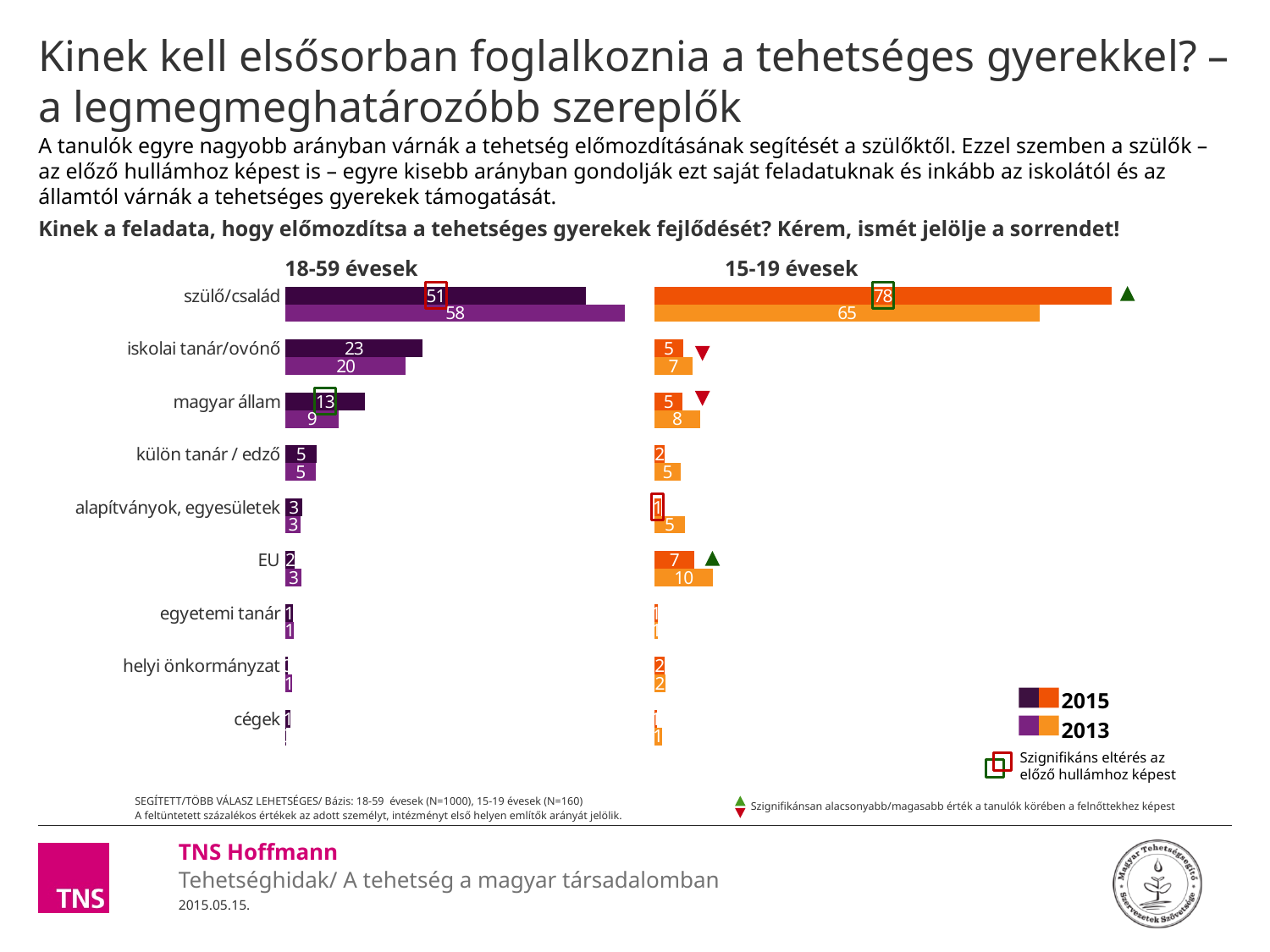
In the "15-19 évesek" chart, what is the difference between the 2015 and 2013 values for szülő/család? 13 In the "15-19 évesek" chart, what is the 2013 value for EU? 10 In the "18-59 évesek" chart, which is larger for magyar állam: the 2015 value or the 2013 value? 2015 In the "18-59 évesek" chart, what is the difference between the 2013 and 2015 values for szülő/család? 7 How many categories are listed in the "18-59 évesek" chart? 9 In the "18-59 évesek" chart, what is the 2013 value for iskolai tanár/ovónő? 20 How many series does the legend list? 2 In the "15-19 évesek" chart, which is larger for EU: the 2015 value or the 2013 value? 2013 In the "15-19 évesek" chart, which category has the highest 2015 value? szülő/család In the "15-19 évesek" chart, what is the 2015 value for szülő/család? 78 What kind of chart is the "15-19 évesek" chart? bar chart In the "18-59 évesek" chart, what is the 2015 value for szülő/család? 51